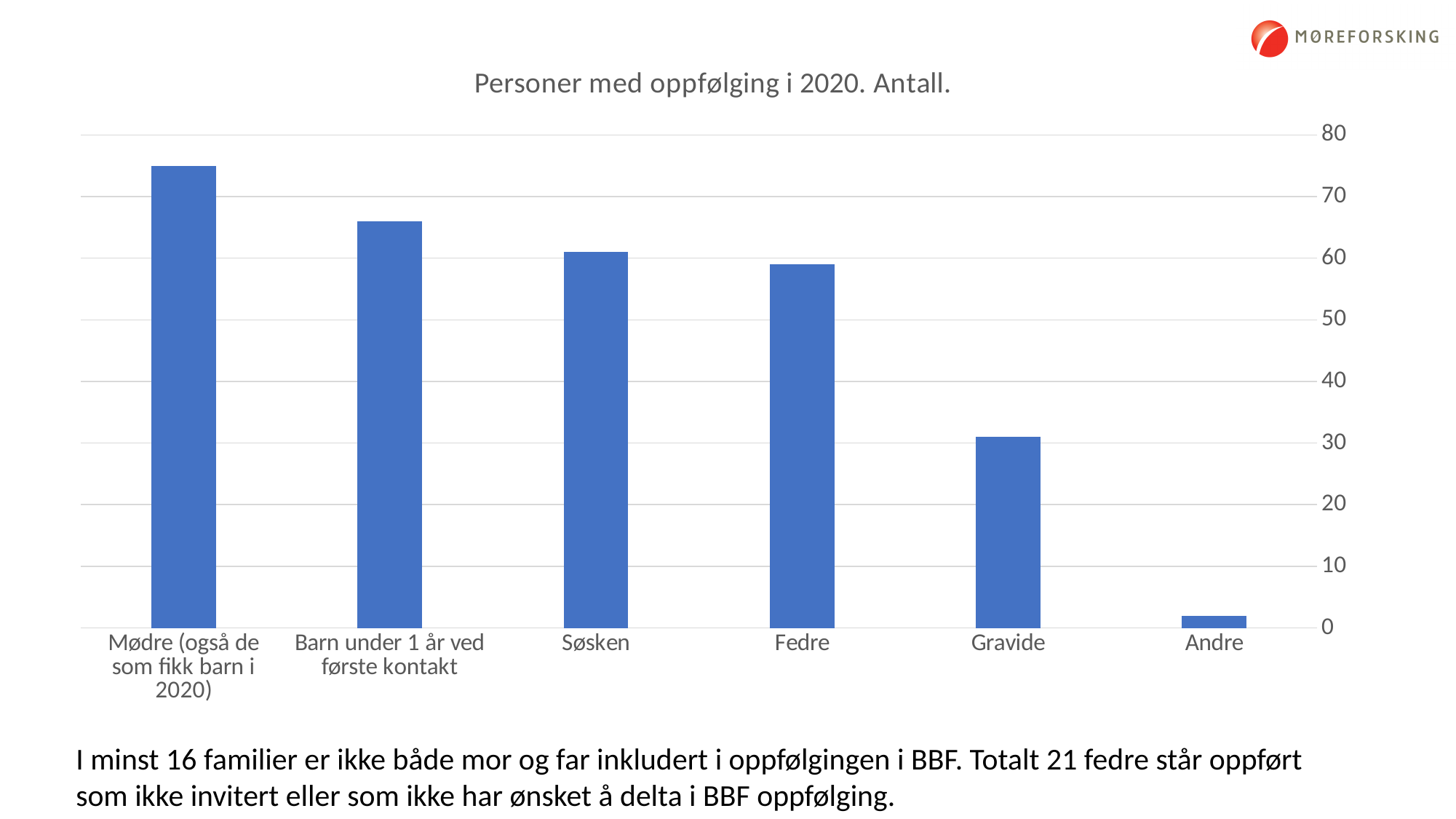
Is the value for Gravide greater or less than 40? less How many categories are shown on the x axis of the chart? 6 Is the value for Andre greater or less than 10? less Which is larger, the value for Fedre or the value for Andre? Fedre Is the value for Fedre greater or less than 50? greater What is the title of the chart? Personer med oppfølging i 2020. Antall. Do the values rise or fall from left to right along the x axis? Fall Which is larger, the value for Barn under 1 år ved første kontakt or the value for Gravide? Barn under 1 år ved første kontakt Which category has the highest value? Mødre (også de som fikk barn i 2020) Which category has the lowest value? Andre What type of chart is shown on the slide? Bar chart